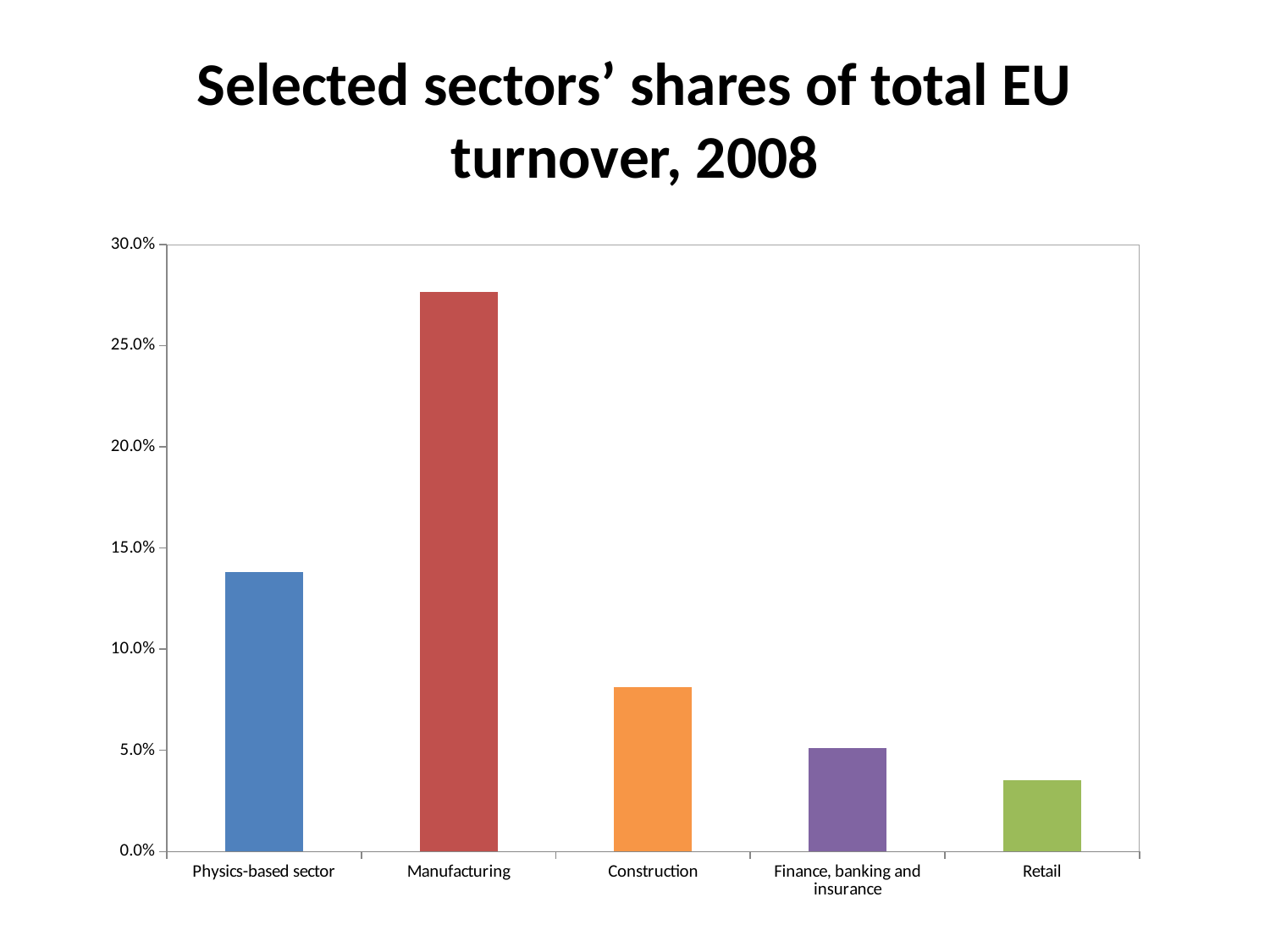
Which is larger, the share for Finance, banking and insurance or the share for Retail? Finance, banking and insurance Is the value for Construction greater or less than 10.0%? less What is the title of the chart? Selected sectors' shares of total EU turnover, 2008 Is the value for Retail greater or less than 5.0%? less Which is larger, the share for Physics-based sector or the share for Construction? Physics-based sector What colour is the bar for Manufacturing? red How many sectors are plotted in the chart? 5 What kind of chart is shown on the slide? bar chart Is the value for Physics-based sector greater or less than 15.0%? less Which sector has the lowest share of total EU turnover? Retail Which sector has the highest share of total EU turnover? Manufacturing